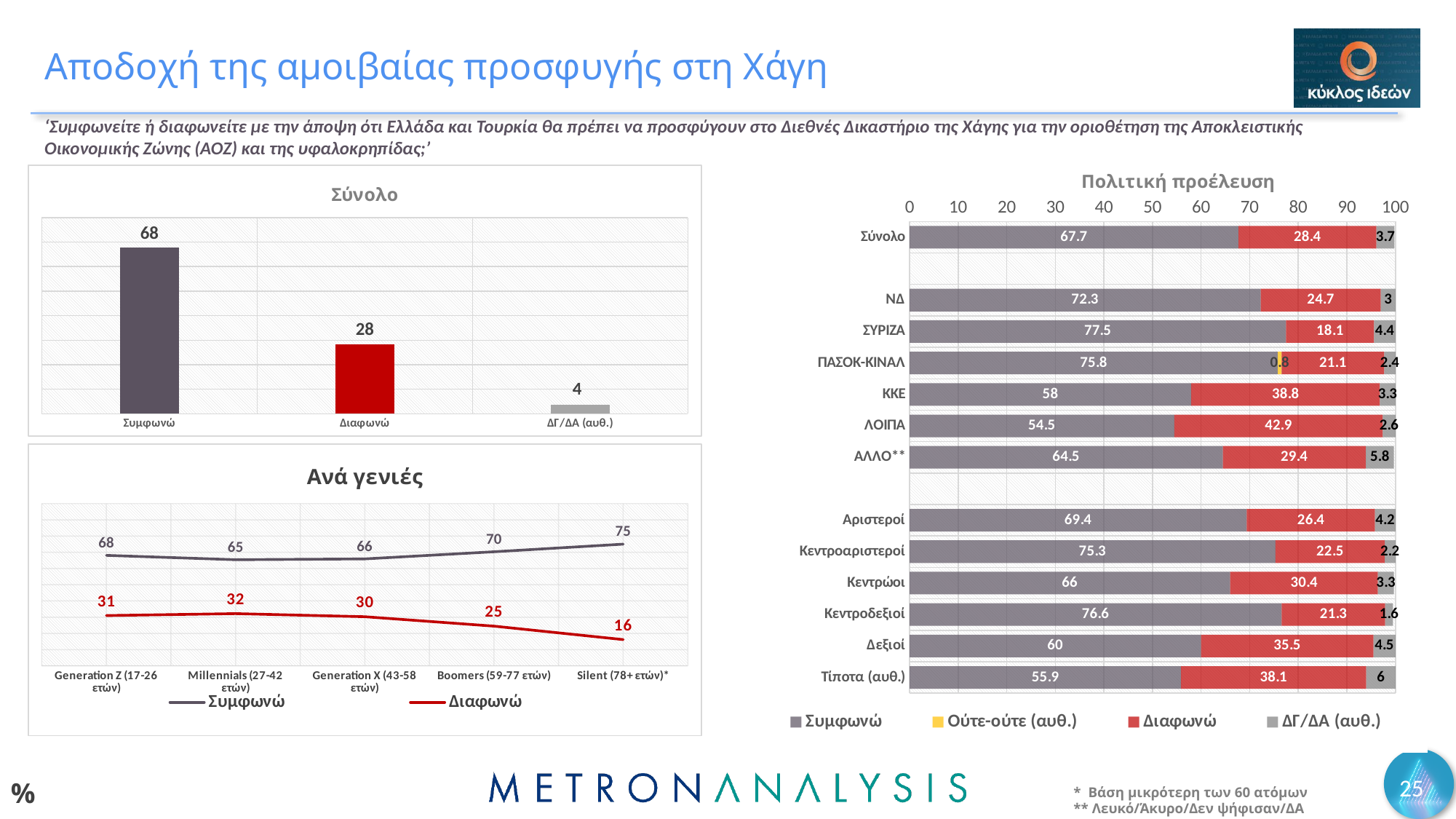
In the 'Πολιτική προέλευση' chart, is the Συμφωνώ value for ΝΔ larger or smaller than for ΚΚΕ? Larger In the 'Ανά γενιές' chart, how many series does the legend list? 2 In the 'Ανά γενιές' chart, what is the Διαφωνώ value for Silent (78+ ετών)? 16 In the 'Ανά γενιές' chart, which generation has the highest Συμφωνώ value? Silent (78+ ετών) In the 'Σύνολο' chart, what is the value for Συμφωνώ? 68 In the 'Πολιτική προέλευση' chart, what is the Συμφωνώ value for ΣΥΡΙΖΑ? 77.5 In the 'Σύνολο' chart, what is the difference between Συμφωνώ and Διαφωνώ? 40 In the 'Σύνολο' chart, which category has the lowest value? ΔΓ/ΔΑ (αυθ.) In the 'Πολιτική προέλευση' chart, which group has the highest Διαφωνώ value? ΛΟΙΠΑ What kind of chart is the 'Σύνολο' chart? Bar chart In the 'Πολιτική προέλευση' chart, how many series does the legend list? 4 In the 'Ανά γενιές' chart, does the Διαφωνώ line rise or fall from Generation X to Silent? Fall